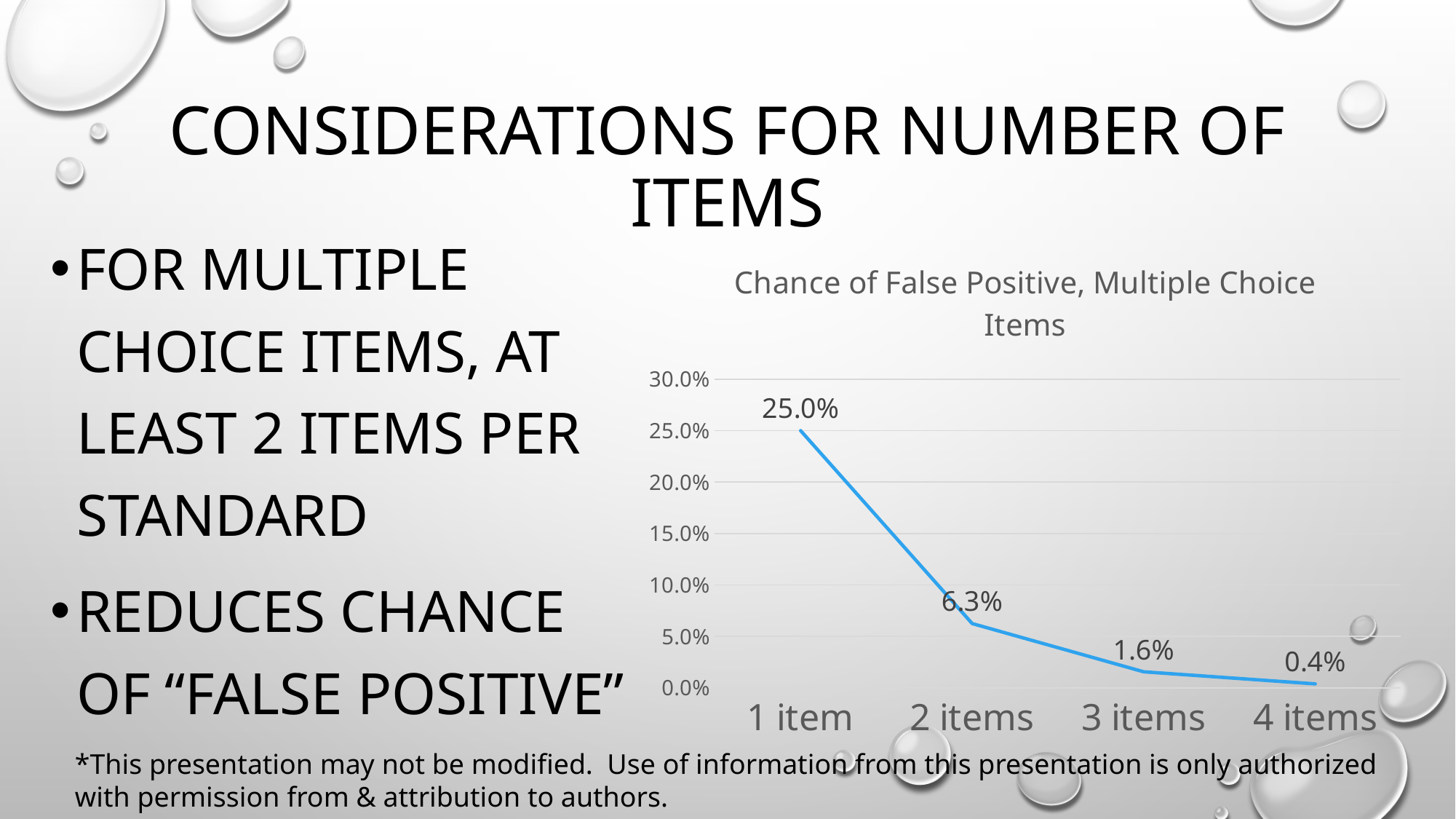
How many categories are plotted on the x axis? 4 What is the chance of false positive for 1 item? 25.0% Which category has the highest chance of false positive? 1 item Which has a larger chance of false positive, 2 items or 3 items? 2 items Which category has the lowest chance of false positive? 4 items Do the values rise or fall as the number of items increases along the x axis? fall What is the chance of false positive for 2 items? 6.3% What is the difference between the chance of false positive for 1 item and for 2 items? 18.7% What is the chance of false positive for 3 items? 1.6% What kind of chart is shown on the slide? line chart Is the chance of false positive for 2 items greater or less than 10.0%? less What is the chance of false positive for 4 items? 0.4%